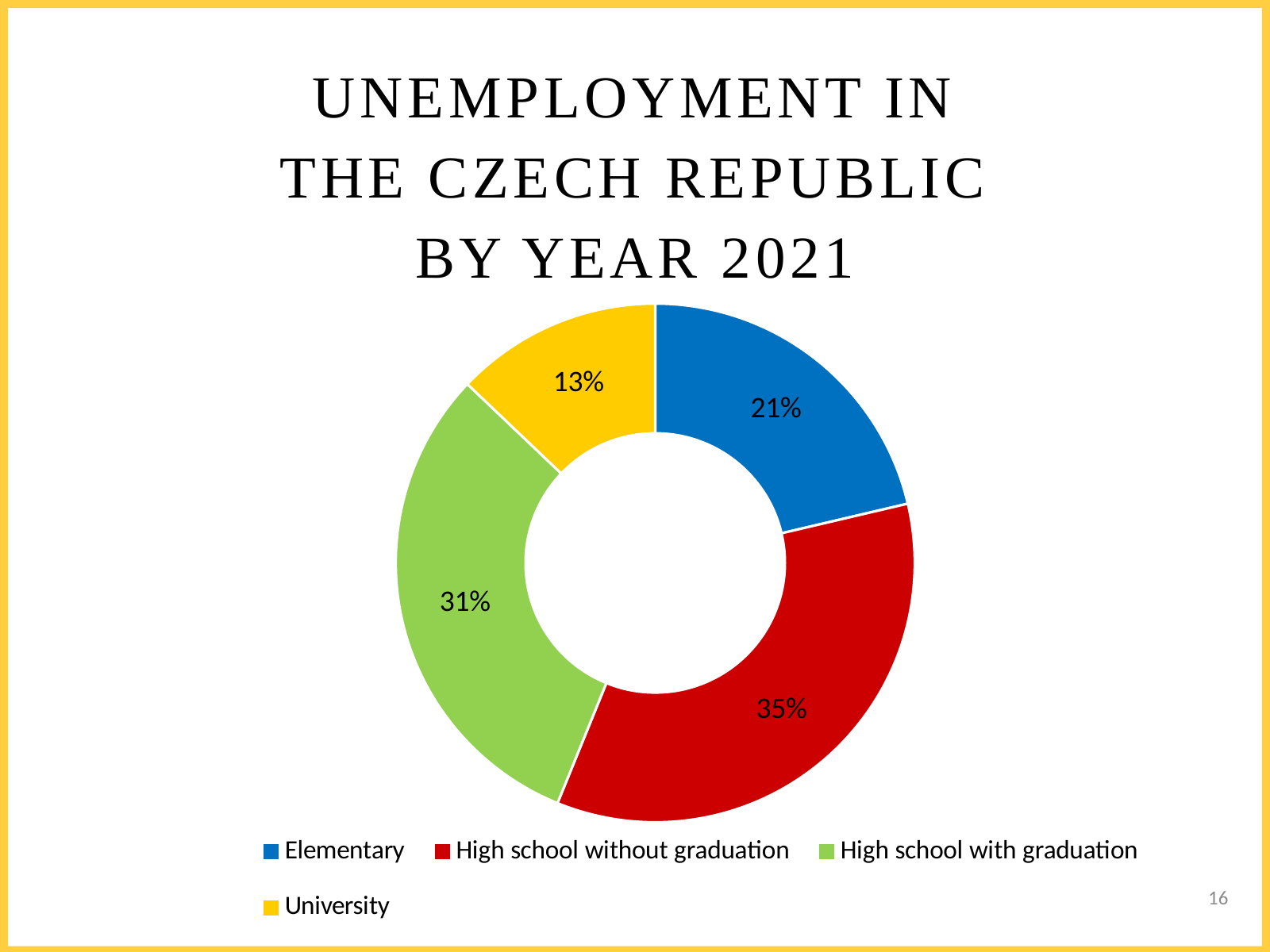
What share of the chart does the University slice represent? 13% What share of the chart does the High school with graduation slice represent? 31% Which colour represents the University category? Yellow What share of the chart does the Elementary slice represent? 21% What share of the chart does the High school without graduation slice represent? 35% Which is larger, the share for Elementary or the share for High school with graduation? High school with graduation Which category has the smallest share? University What is the title of the slide? Unemployment in the Czech Republic by year 2021 What kind of chart is shown on the slide? Doughnut (pie) chart Which category has the largest share? High school without graduation How many categories are shown in the chart? 4 What is the difference between the shares for High school without graduation and University? 22%